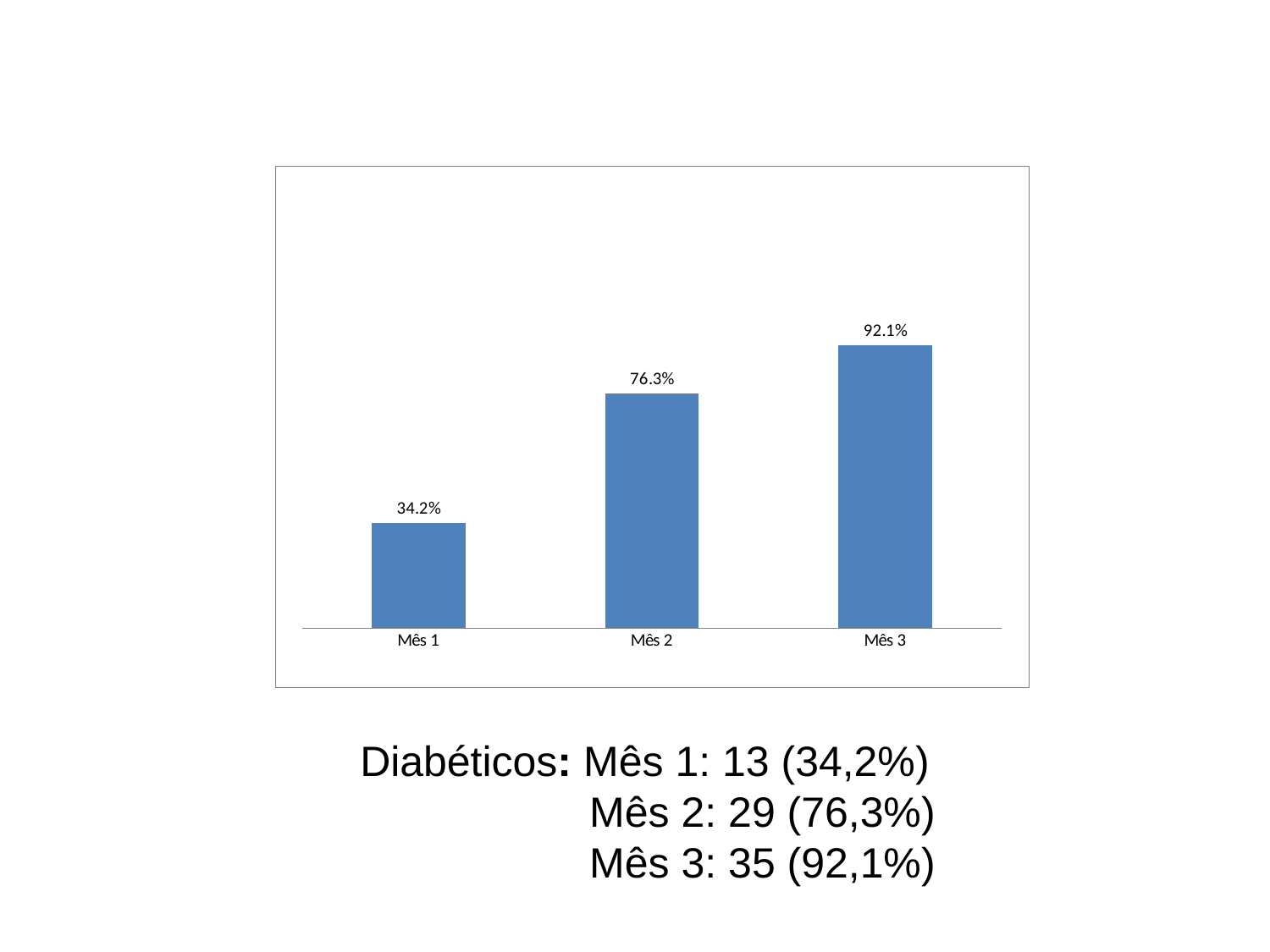
How many categories are shown on the x axis? 3 Which category has the lowest value? Mês 1 What colour are the bars in the chart? Blue What kind of chart is shown on the slide? Bar chart Do the values rise or fall from Mês 1 to Mês 3? Rise What is the value for Mês 2? 76.3% What is the difference between the values for Mês 3 and Mês 1? 57.9% What is the difference between the values for Mês 2 and Mês 1? 42.1% Which is larger, the value for Mês 2 or the value for Mês 3? Mês 3 Which category has the highest value? Mês 3 What is the value for Mês 1? 34.2% What is the value for Mês 3? 92.1%